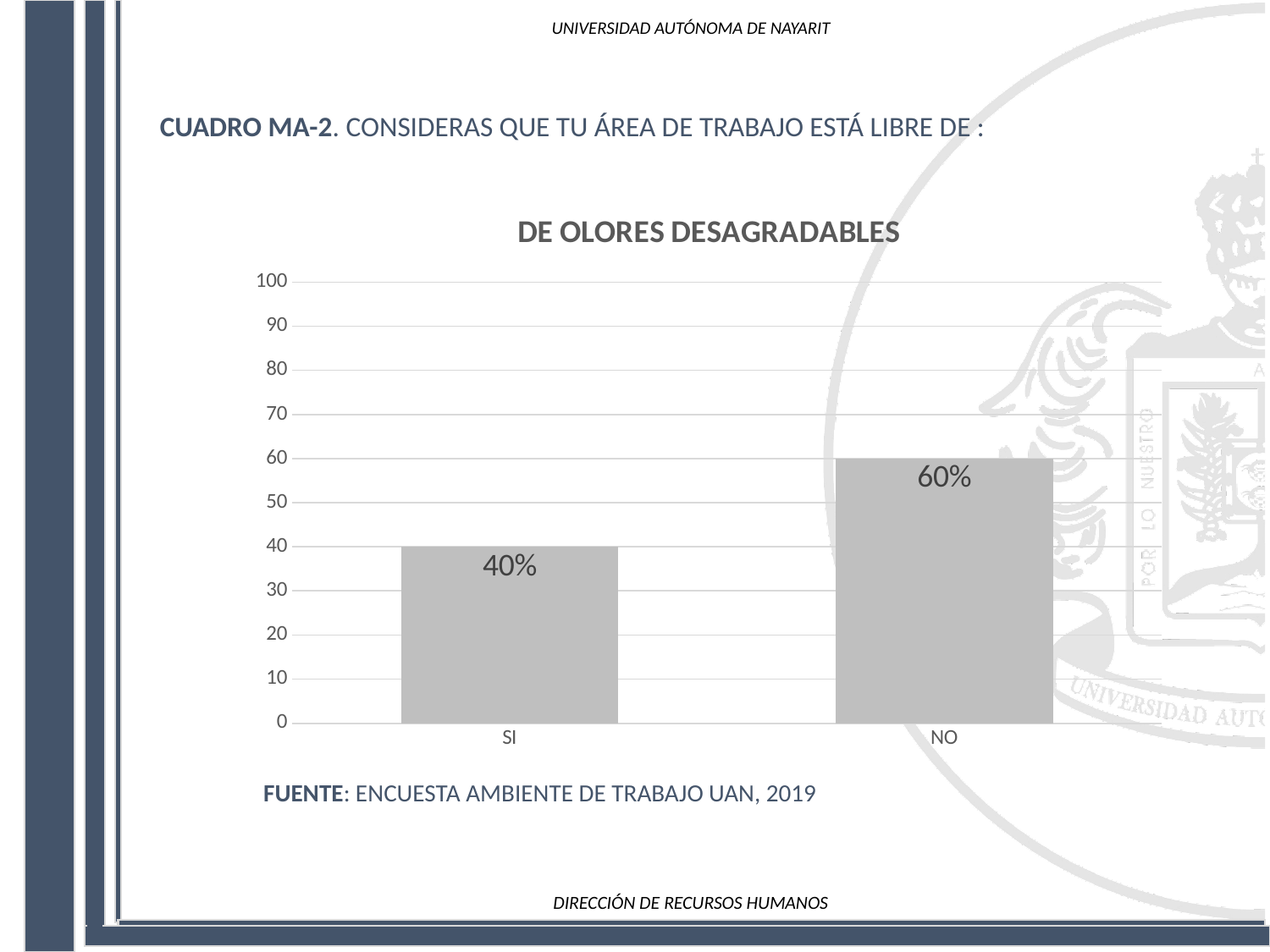
Which category has the lowest value? SI Which category has the highest value? NO What is the value for NO? 60% Is the value for SI greater or less than 50? less What is the difference between the values for NO and SI? 20% Is the value for NO greater or less than 50? greater What is the maximum value shown on the y axis? 100 What kind of chart is shown on the slide? bar chart How many categories are shown on the x axis? 2 What is the value for SI? 40% What is the title of the chart? DE OLORES DESAGRADABLES Which is larger, the value for SI or the value for NO? NO